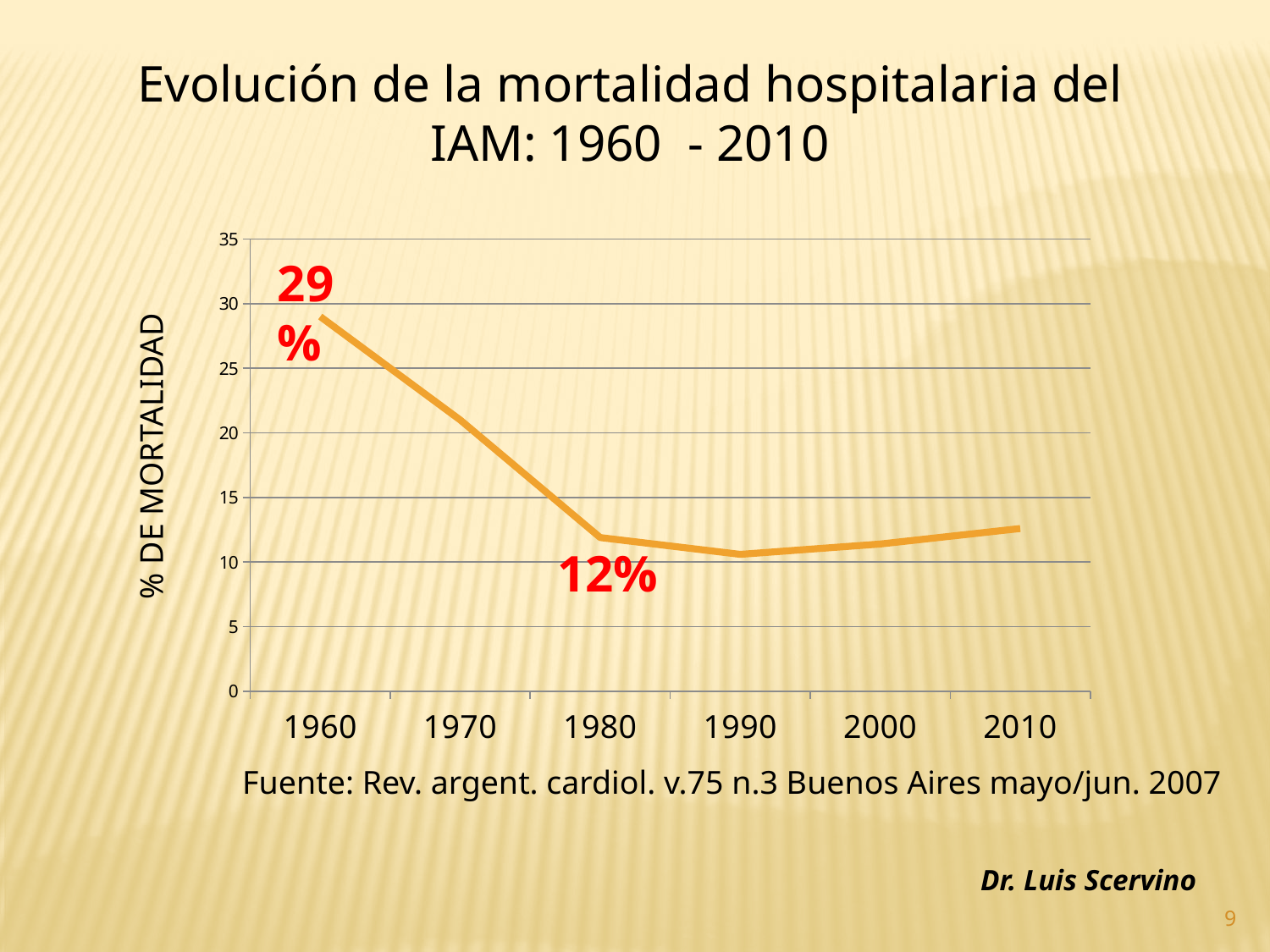
What is the label on the vertical axis of the chart? % DE MORTALIDAD Which year has the highest mortality value on the chart? 1960 Is the value for 1990 greater or less than 15? less Is the value for 1970 greater or less than 15? greater What is the hospital mortality value shown for 1960? 29% What kind of chart is shown on the slide? line chart Does the mortality value rise or fall from 1960 to 1980? fall How many years are plotted on the x axis? 6 What is the hospital mortality value shown for 1980? 12% Which is larger, the value for 1970 or the value for 2000? 1970 Is the value for 2010 greater or less than 15? less By how many percentage points did mortality fall between 1960 and 1980? 17 percentage points